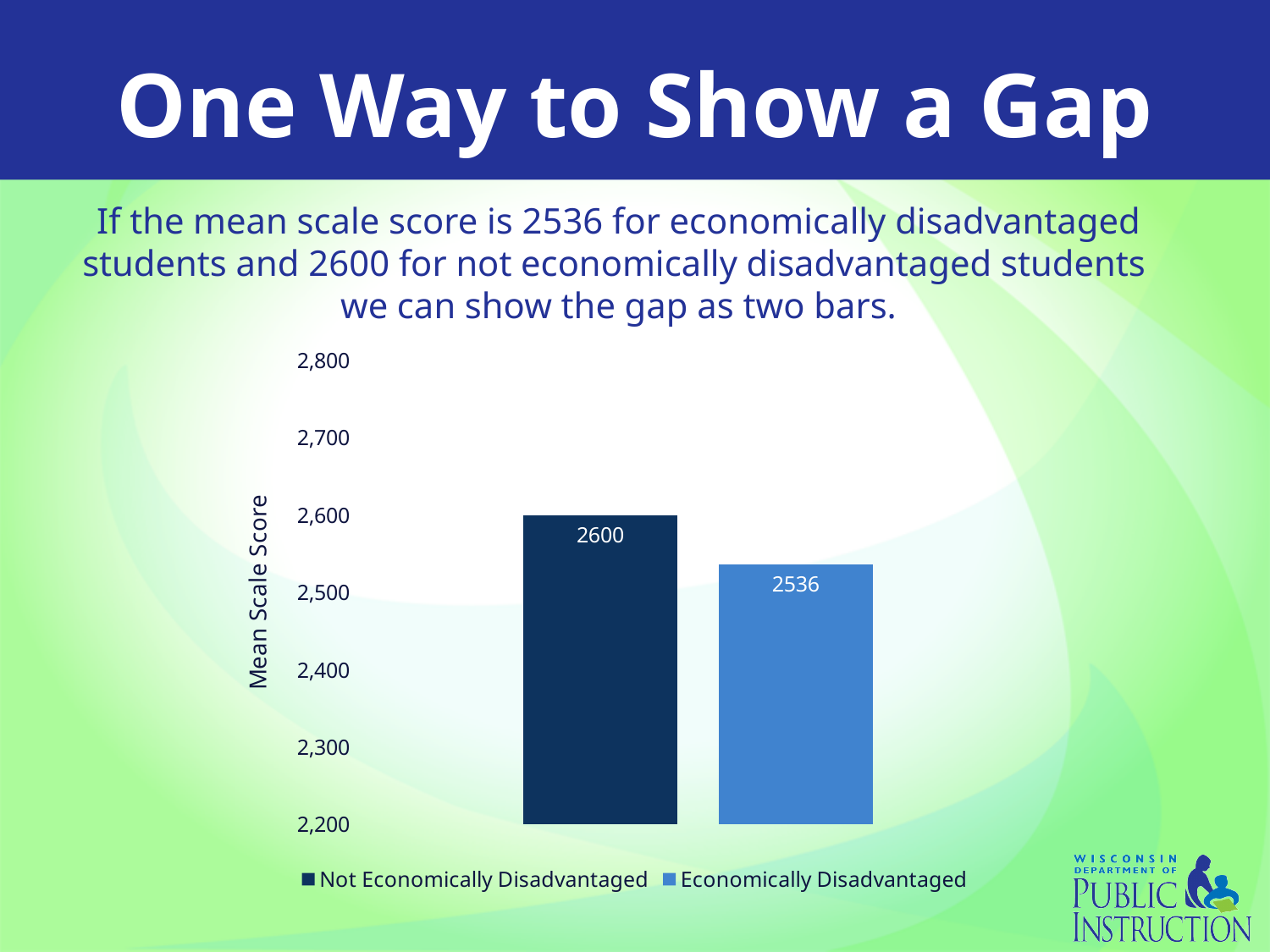
Which group has the lower mean scale score? Economically Disadvantaged How many series does the legend list? 2 What is the highest value shown on the vertical axis? 2,800 What is the label on the vertical axis of the chart? Mean Scale Score What is the mean scale score for Not Economically Disadvantaged students? 2600 What kind of chart is shown on the slide? Bar chart Is the mean scale score for Not Economically Disadvantaged students greater or less than 2,700? less What is the mean scale score for Economically Disadvantaged students? 2536 Is the mean scale score for Economically Disadvantaged students greater or less than 2,500? greater How many bars are plotted in the chart? 2 Which group has the higher mean scale score? Not Economically Disadvantaged What is the difference between the mean scale scores of Not Economically Disadvantaged and Economically Disadvantaged students? 64